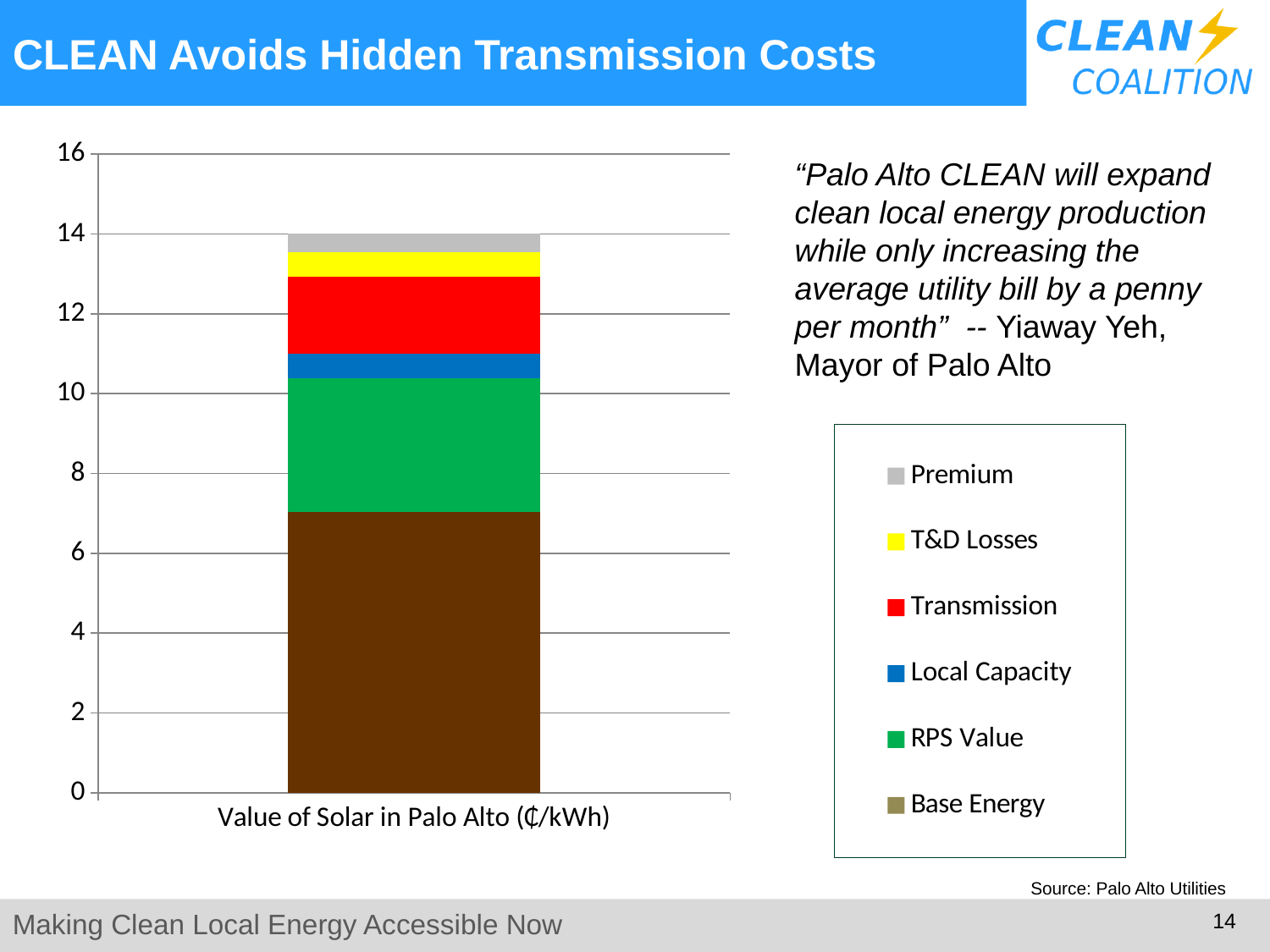
How many series does the legend list? 6 What is the total height of the stacked bar for Value of Solar in Palo Alto (¢/kWh)? 14 Which segment is larger, Base Energy or RPS Value? Base Energy Which segment is larger, Transmission or Local Capacity? Transmission Is the Base Energy segment of the bar greater or less than 6? greater What colour represents Transmission in the legend? Red What kind of chart is shown on the slide? Stacked bar chart Is the Premium segment of the bar greater or less than 2? less How many bars (categories) are plotted on the chart? 1 Is the total height of the stacked bar greater or less than 12? greater Which series makes up the largest segment of the stacked bar? Base Energy